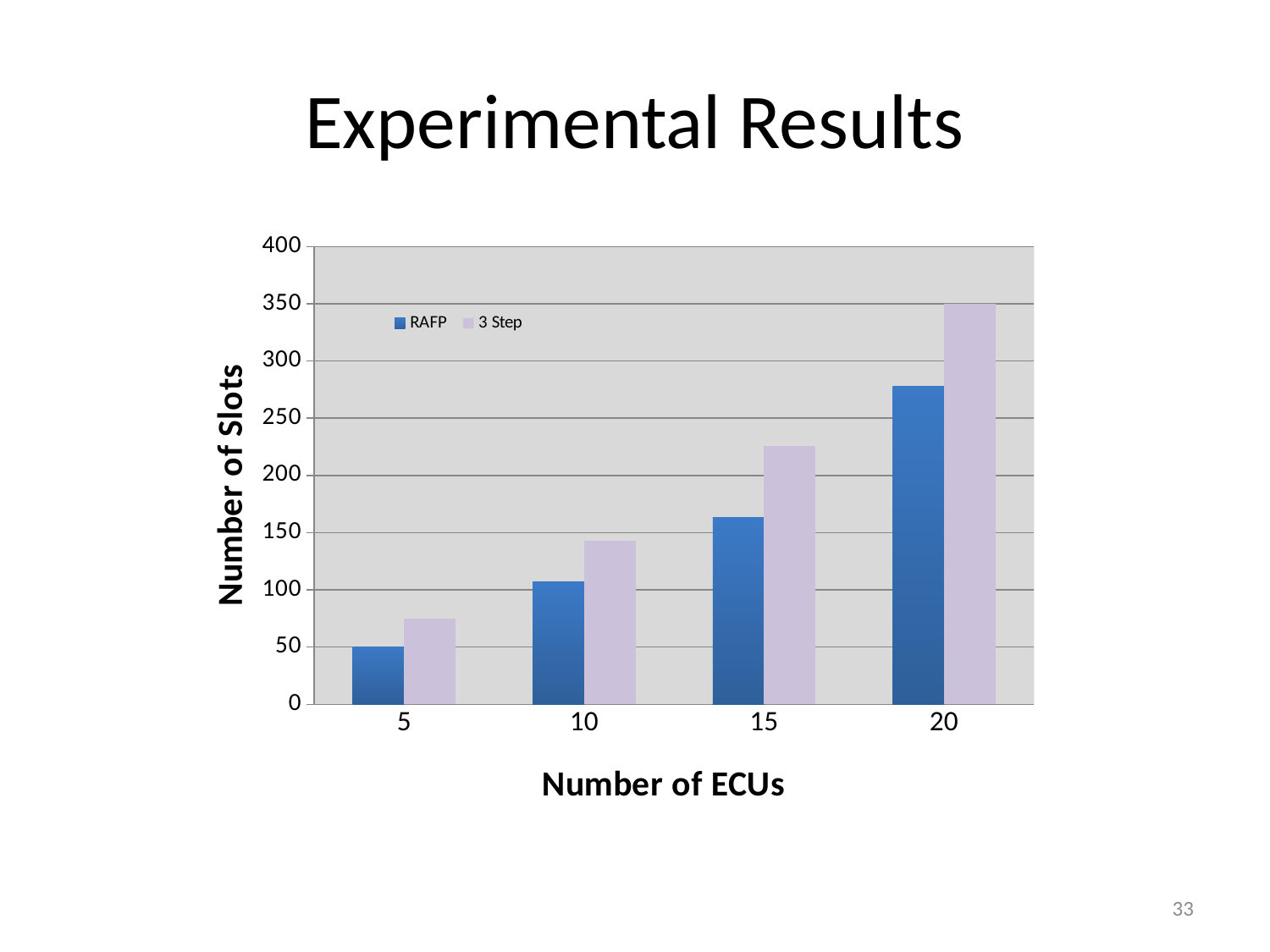
How many categories are shown on the x axis? 4 Which number of ECUs has the highest 3 Step value? 20 Is the 3 Step value at 15 ECUs greater or less than 250? less How many series does the legend list? 2 What kind of chart is shown on the slide? bar chart What is the label of the y axis? Number of Slots Which series has the highest value at 20 ECUs? 3 Step Is the RAFP value at 20 ECUs greater or less than 250? greater Is the RAFP value at 10 ECUs greater or less than 100? greater At 15 ECUs, which series has the larger value, RAFP or 3 Step? 3 Step Which number of ECUs has the lowest RAFP value? 5 Do the RAFP values rise or fall as the number of ECUs increases? rise